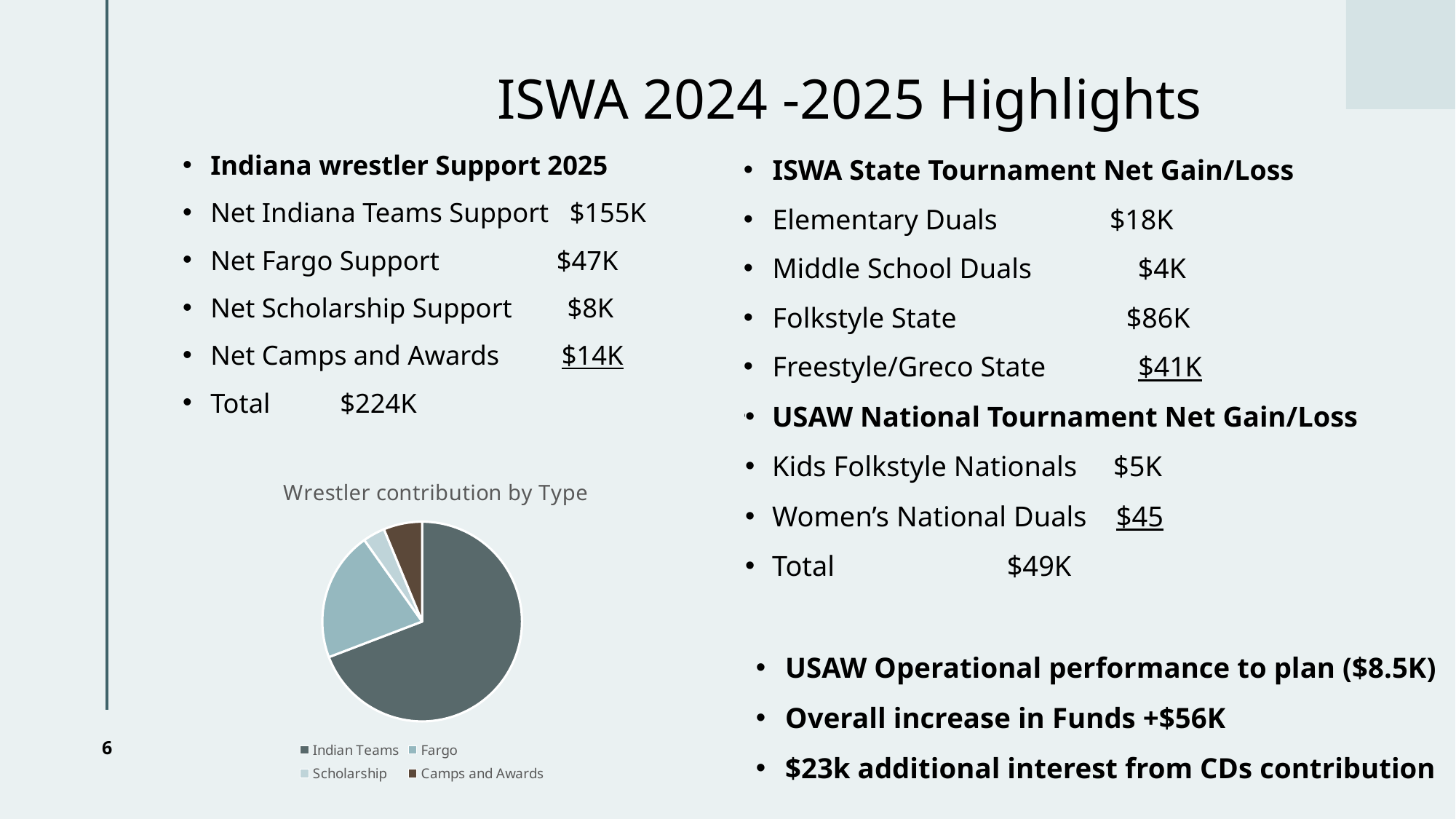
What is the title of the pie chart? Wrestler contribution by Type How many slices does the pie chart have? 4 What kind of chart is shown on the slide? Pie chart In the pie chart, which slice is larger: Fargo or Camps and Awards? Fargo How many entries does the pie chart's legend list? 4 Does the Indian Teams slice take up more or less than half of the pie? More than half Which category has the largest slice in the pie chart? Indian Teams Which legend entry is shown in brown in the pie chart? Camps and Awards In the pie chart, which slice is larger: Indian Teams or Fargo? Indian Teams Which category has the smallest slice in the pie chart? Scholarship